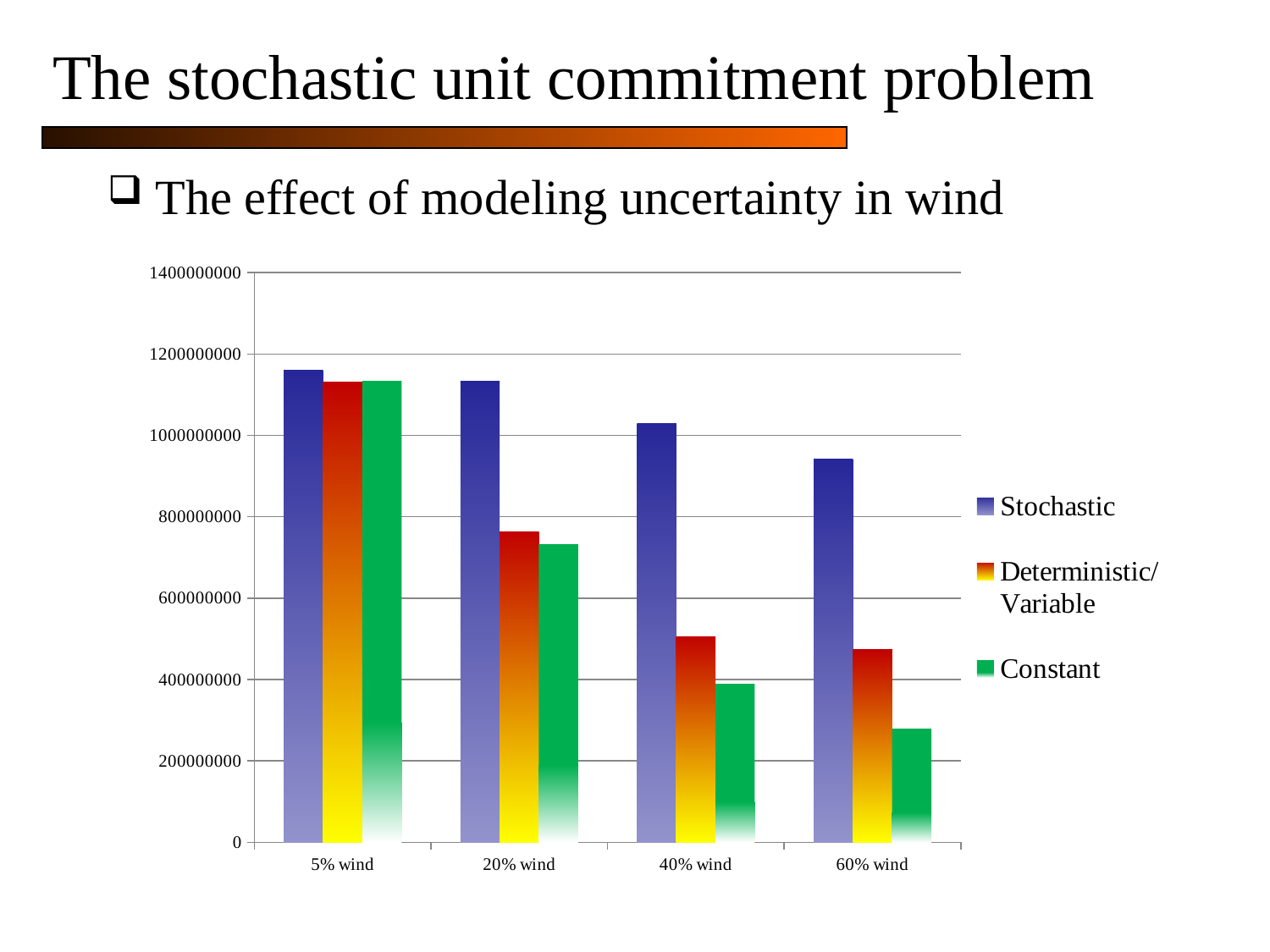
Do the Constant values rise or fall as the wind level increases along the x axis? fall Which wind-level category has the lowest Stochastic value? 60% wind Is the Stochastic value for 60% wind greater or less than 800000000? greater How many wind-level categories are shown on the x axis? 4 Which wind-level category has the lowest Constant value? 60% wind How many series does the legend list? 3 Is the Stochastic value for 5% wind greater or less than 1000000000? greater Is the Deterministic/Variable value for 40% wind greater or less than 600000000? less What are the three series named in the legend? Stochastic, Deterministic/Variable, Constant At 40% wind, which is larger: the Stochastic value or the Constant value? Stochastic What kind of chart is shown on the slide? bar chart